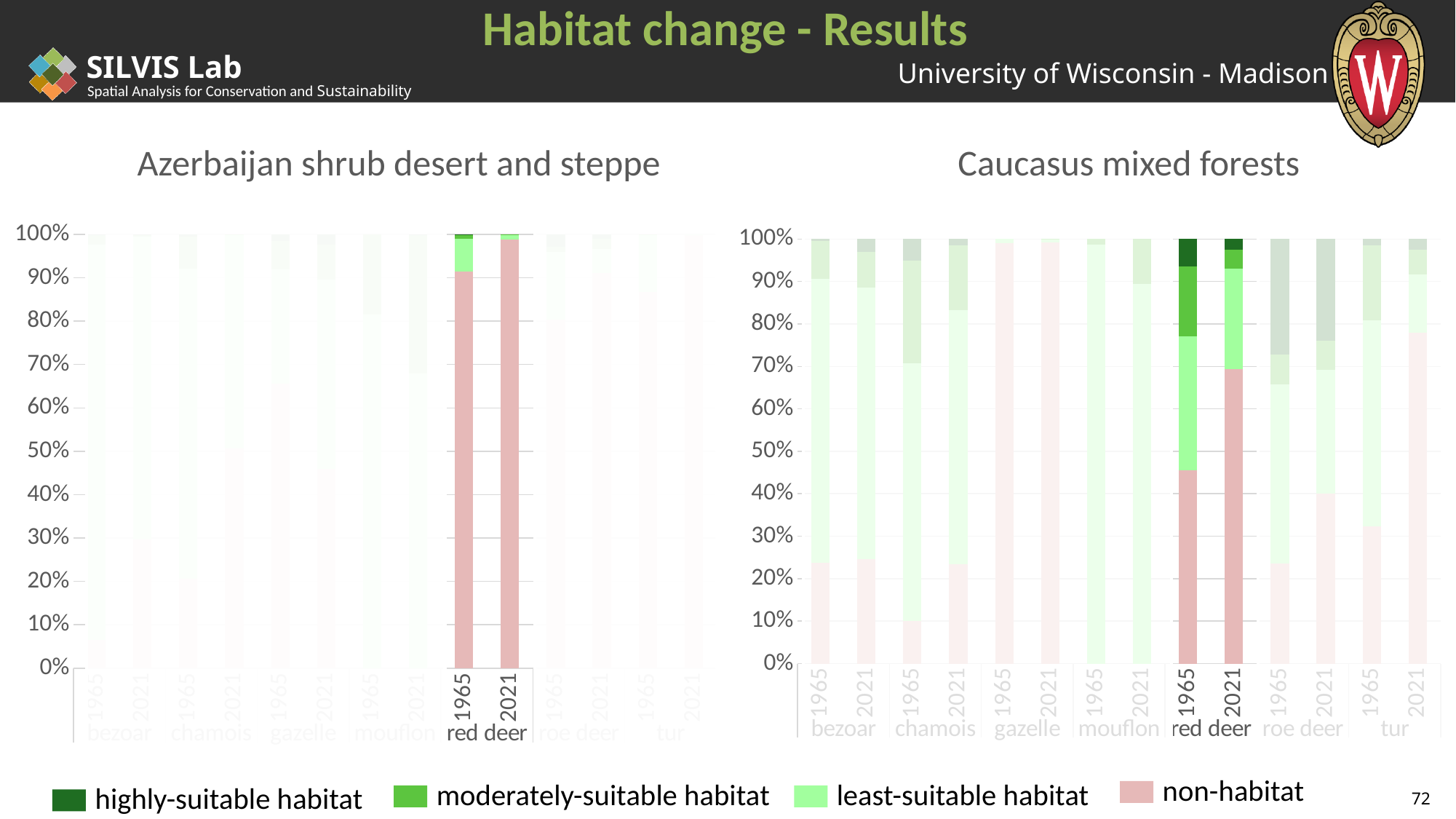
In the Caucasus mixed forests chart, is the non-habitat share for red deer in 1965 greater or less than 50%? less Which species is highlighted (not faded) in both charts on the slide? red deer What is the title of the chart on the right side of the slide? Caucasus mixed forests In the Caucasus mixed forests chart, is the non-habitat share for red deer in 2021 greater or less than 60%? greater In the Azerbaijan shrub desert and steppe chart, is the non-habitat share for red deer in 1965 greater or less than 80%? greater In the Caucasus mixed forests chart, which year has the larger highly-suitable habitat share for red deer, 1965 or 2021? 1965 What kind of chart is used on the slide for the Azerbaijan shrub desert and steppe data? stacked bar chart In the Caucasus mixed forests chart, which year has the larger non-habitat share for red deer, 1965 or 2021? 2021 In the Azerbaijan shrub desert and steppe chart, does the non-habitat share for red deer rise or fall from 1965 to 2021? rise In the Caucasus mixed forests chart, how many species are shown on the x axis? 7 How many series does the legend at the bottom of the slide list? 4